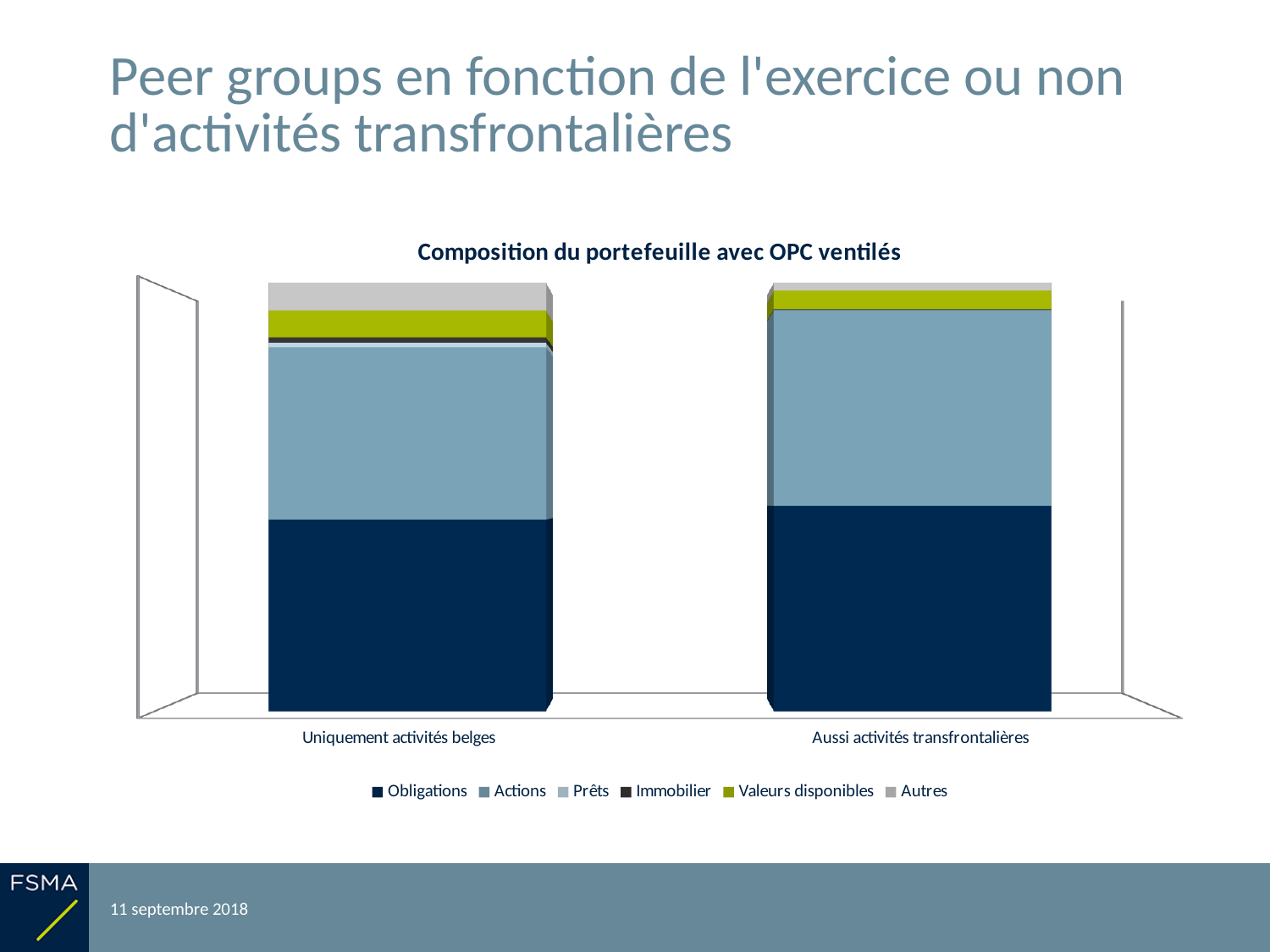
Which series forms the largest segment of the bar for 'Aussi activités transfrontalières'? Obligations Which series is listed first in the legend? Obligations What type of chart is shown on the slide? Stacked bar chart In the bar for 'Uniquement activités belges', which segment is larger: Obligations or Actions? Obligations Which series forms the largest segment of the bar for 'Uniquement activités belges'? Obligations How many series does the legend list? 6 How many categories are shown on the x axis of the chart? 2 Which category has the larger 'Actions' segment? Aussi activités transfrontalières What are the two categories shown on the x axis? Uniquement activités belges; Aussi activités transfrontalières What is the title of the chart? Composition du portefeuille avec OPC ventilés